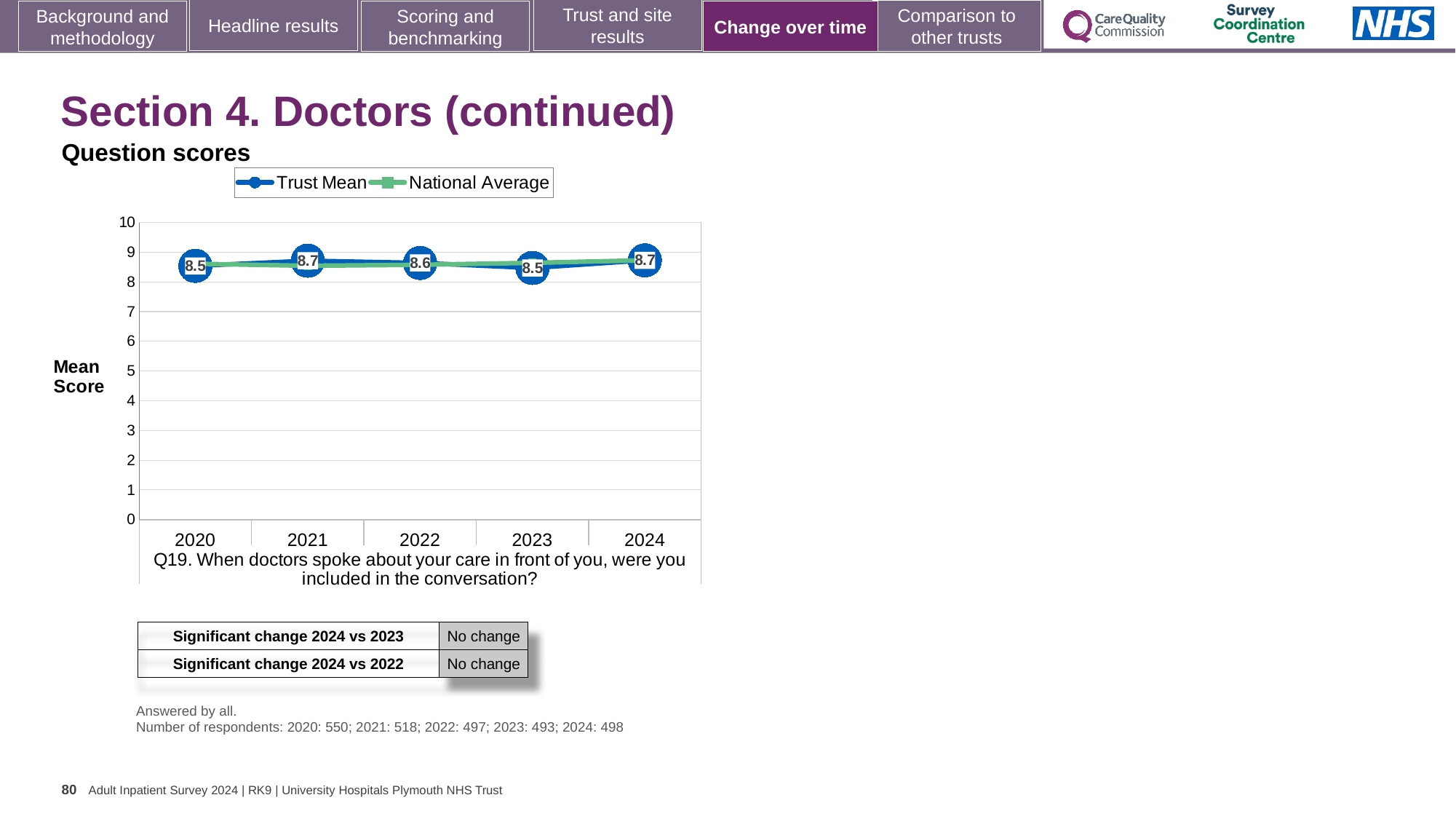
Does the Trust Mean score rise or fall from 2023 to 2024? Rise What are the two series named in the chart legend? Trust Mean and National Average What is the difference between the Trust Mean scores for 2024 and 2023? 0.2 What is the label on the y axis of the chart? Mean Score Which year has the larger Trust Mean score, 2021 or 2022? 2021 What is the Trust Mean score for 2020? 8.5 What kind of chart is shown on the slide? Line chart How many years are shown on the x axis of the chart? 5 How many series does the chart legend list? 2 What is the Trust Mean score for 2024? 8.7 Is the National Average value for 2024 greater or less than 8? greater What is the Trust Mean score for 2022? 8.6